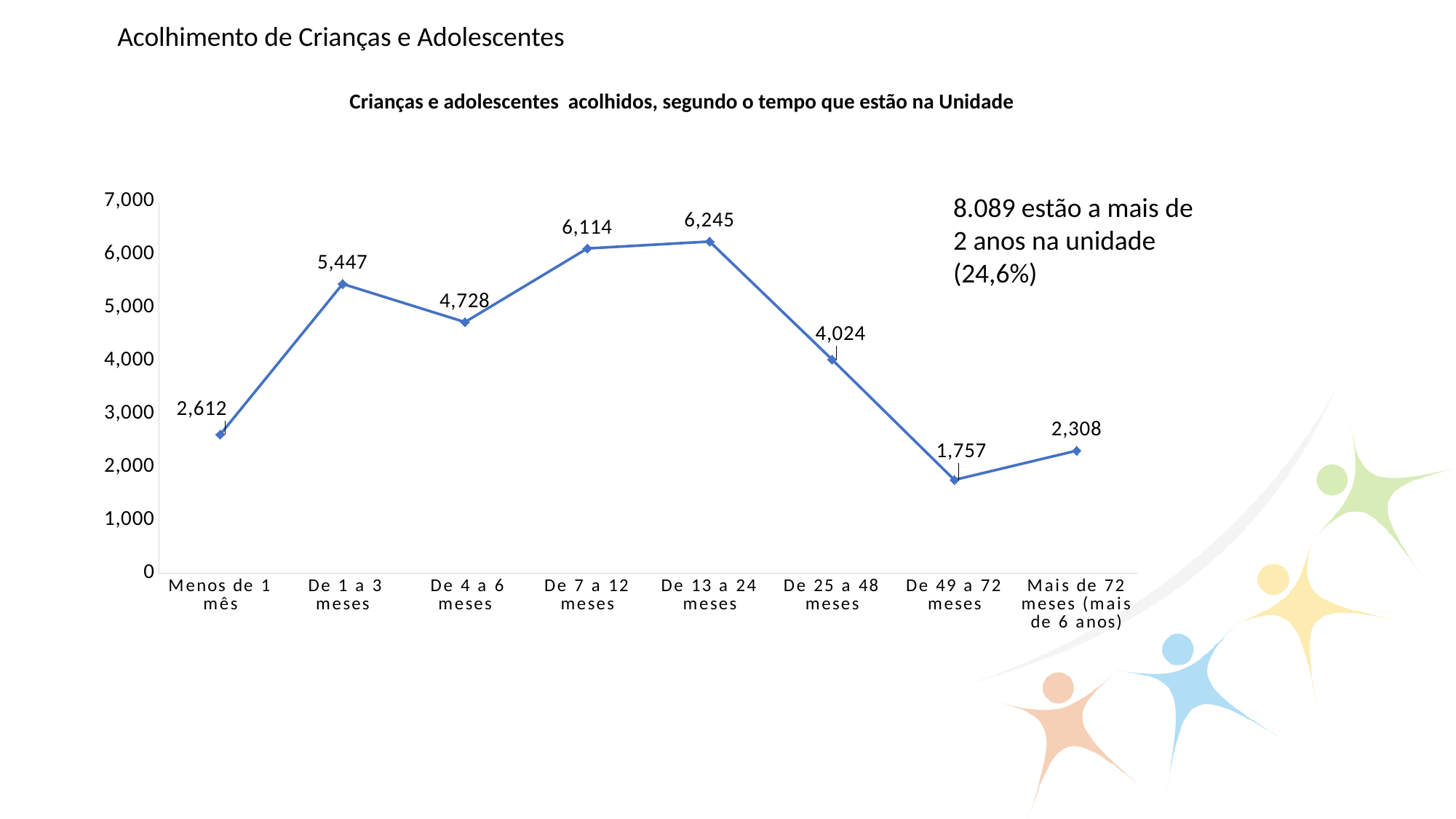
Which is larger, the value for 'De 1 a 3 meses' or the value for 'De 4 a 6 meses'? De 1 a 3 meses What kind of chart is shown on the slide? line chart What is the value for 'De 49 a 72 meses'? 1,757 How many categories are shown on the x axis? 8 What is the difference between the values for 'De 13 a 24 meses' and 'De 7 a 12 meses'? 131 What is the value for 'Menos de 1 mês'? 2,612 What is the value for 'De 13 a 24 meses'? 6,245 Is the value for 'De 25 a 48 meses' greater or less than 5,000? less What is the title of the chart? Crianças e adolescentes acolhidos, segundo o tempo que estão na Unidade Which category has the highest value? De 13 a 24 meses Which category has the lowest value? De 49 a 72 meses Do the values rise or fall from 'De 13 a 24 meses' to 'De 49 a 72 meses'? fall